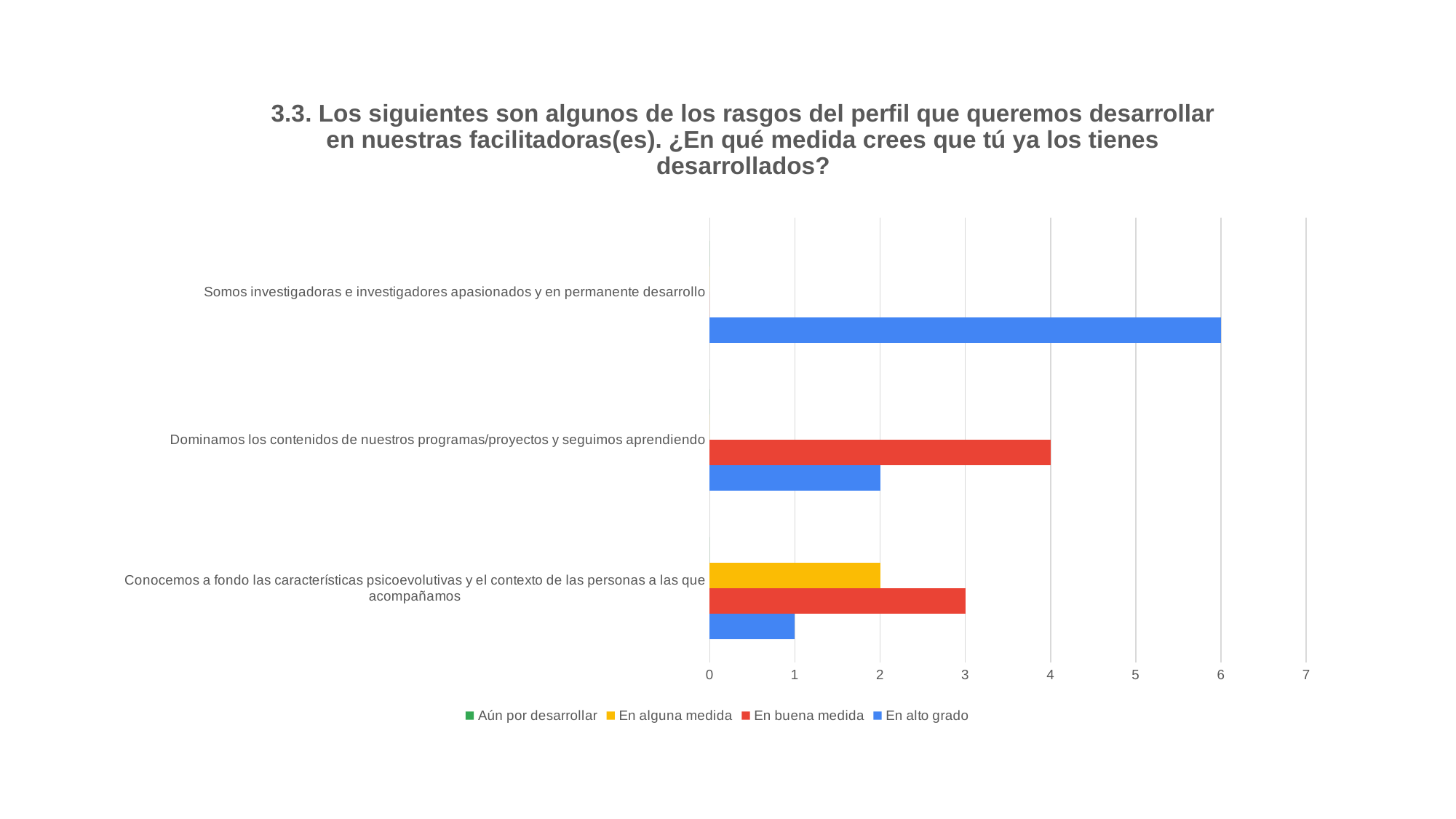
Which category has the highest value for 'En alto grado'? Somos investigadoras e investigadores apasionados y en permanente desarrollo What is the value of 'En alguna medida' for 'Conocemos a fondo las características psicoevolutivas y el contexto de las personas a las que acompañamos'? 2 What is the value of 'En buena medida' for 'Dominamos los contenidos de nuestros programas/proyectos y seguimos aprendiendo'? 4 What is the value of 'En alto grado' for 'Somos investigadoras e investigadores apasionados y en permanente desarrollo'? 6 What is the value of 'En alto grado' for 'Conocemos a fondo las características psicoevolutivas y el contexto de las personas a las que acompañamos'? 1 How many categories are shown on the chart? 3 What is the value of 'En alto grado' for 'Dominamos los contenidos de nuestros programas/proyectos y seguimos aprendiendo'? 2 How many series does the legend list? 4 What kind of chart is shown on the slide? bar chart What is the difference between 'En buena medida' and 'En alto grado' for 'Dominamos los contenidos de nuestros programas/proyectos y seguimos aprendiendo'? 2 Which legend entry is shown in green? Aún por desarrollar For 'Conocemos a fondo las características psicoevolutivas y el contexto de las personas a las que acompañamos', which is larger: 'En buena medida' or 'En alto grado'? En buena medida